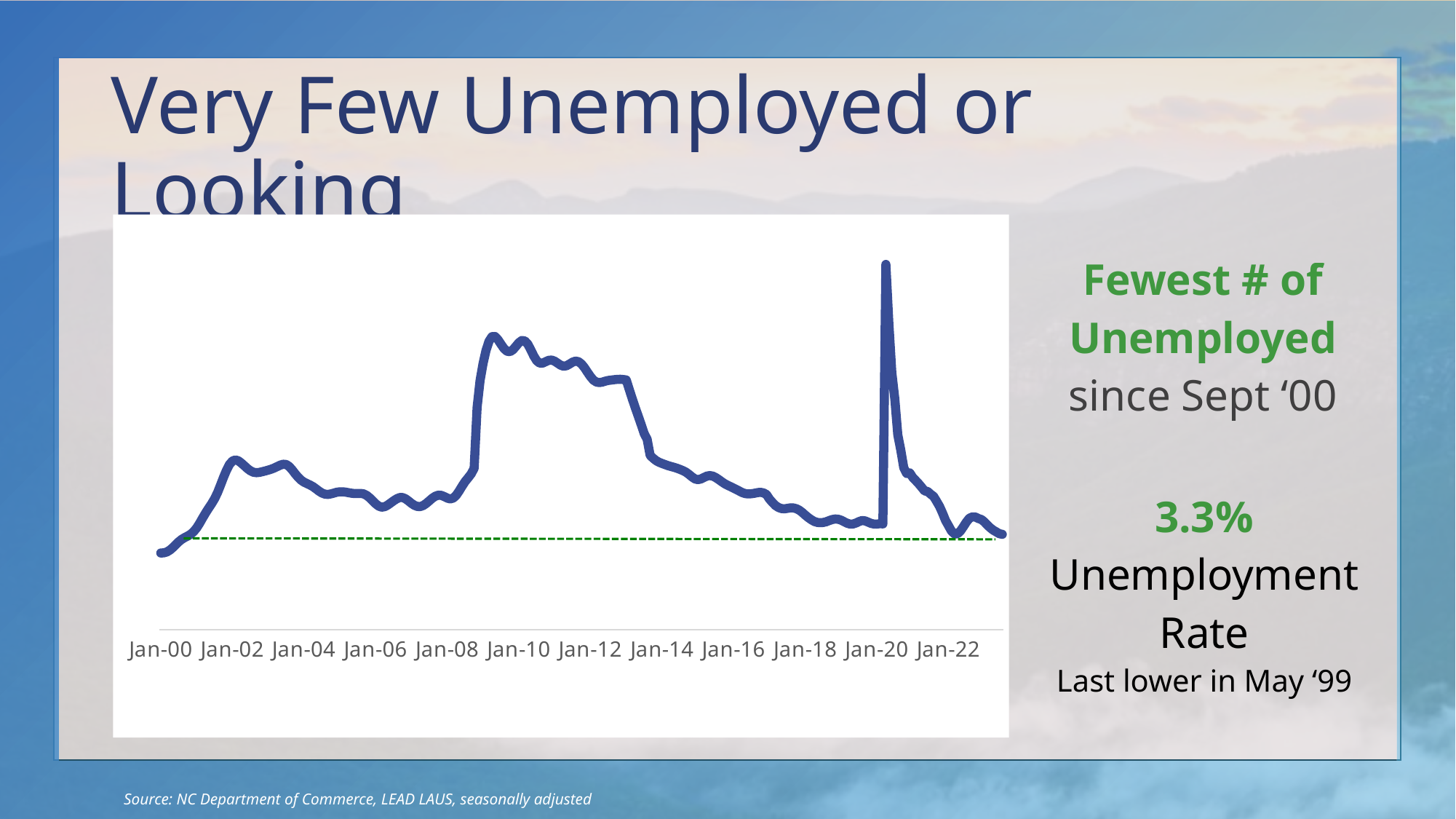
What kind of chart is shown on the slide? line chart Which is higher on the chart, the value at Jan-02 or the value at Jan-06? Jan-02 Does the line rise or fall between Jan-10 and Jan-18? fall Near which x-axis label does the line reach its highest point? Jan-20 Which is higher on the chart, the value at Jan-14 or the value at Jan-16? Jan-14 Does the line rise or fall between Jan-08 and Jan-10? rise Is the line's lowest point near the start of the chart (Jan-00) or near the end (after Jan-22)? near the start (Jan-00) What is the first label on the x axis of the chart? Jan-00 Which is higher on the chart, the value at Jan-10 or the value at Jan-18? Jan-10 What colour is the dashed horizontal reference line on the chart? green Does the line rise or fall between Jan-00 and Jan-02? rise How many labels are shown on the x axis of the chart? 12